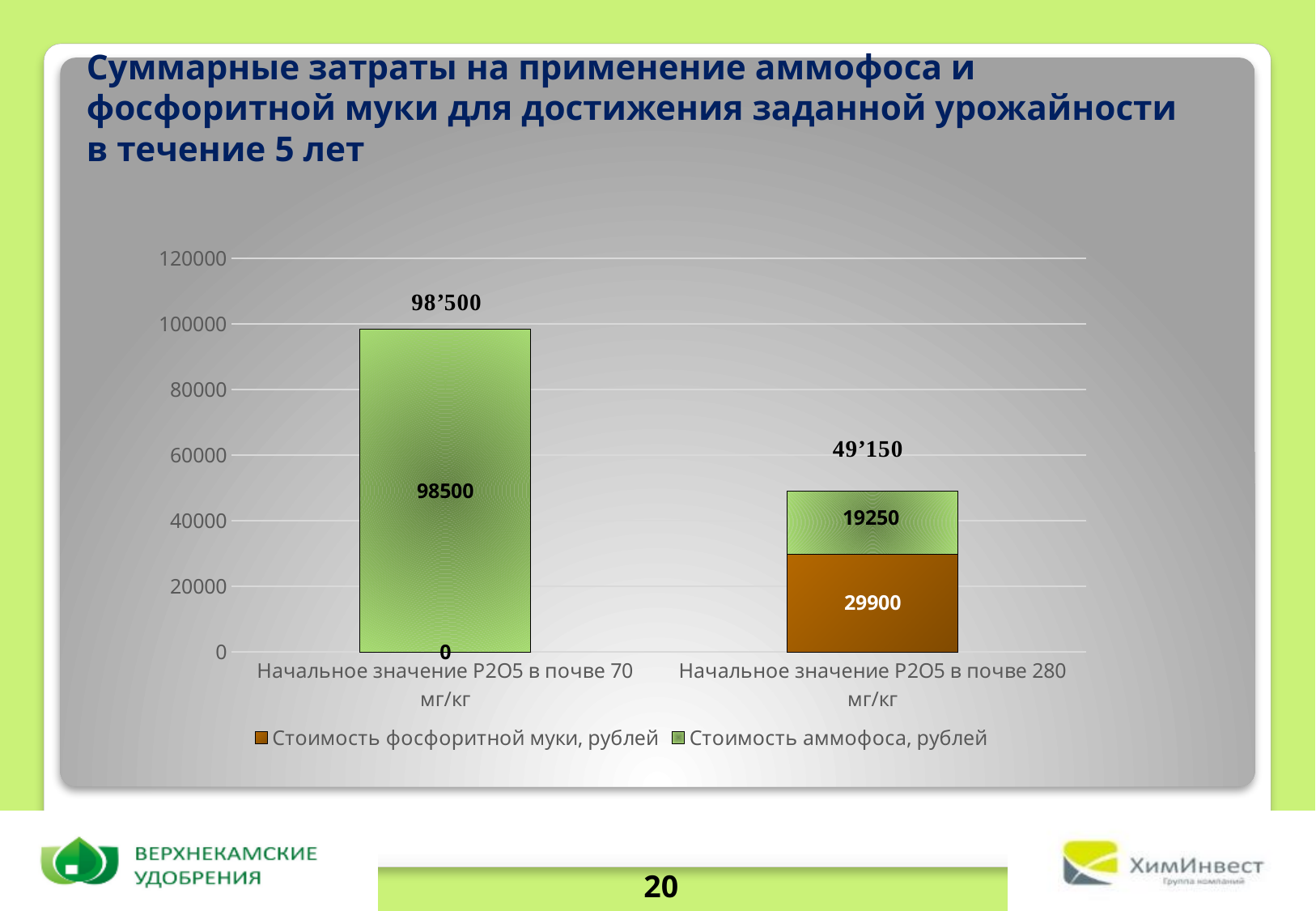
What is the value of 'Стоимость аммофоса, рублей' for 'Начальное значение P2O5 в почве 280 мг/кг'? 19250 What is the difference between the 'Стоимость аммофоса, рублей' values for the two categories? 79250 What is the value of 'Стоимость фосфоритной муки, рублей' for 'Начальное значение P2O5 в почве 70 мг/кг'? 0 Is the total for 'Начальное значение P2O5 в почве 280 мг/кг' greater or less than 60000? less What is the value of 'Стоимость фосфоритной муки, рублей' for 'Начальное значение P2O5 в почве 280 мг/кг'? 29900 What is the value of 'Стоимость аммофоса, рублей' for 'Начальное значение P2O5 в почве 70 мг/кг'? 98500 Which category has the higher total cost? Начальное значение P2O5 в почве 70 мг/кг What is the total of the stacked bar for 'Начальное значение P2O5 в почве 280 мг/кг'? 49’150 What is the total of the stacked bar for 'Начальное значение P2O5 в почве 70 мг/кг'? 98’500 How many categories are shown on the x axis? 2 What kind of chart is shown on the slide? stacked bar chart How many series does the legend list? 2